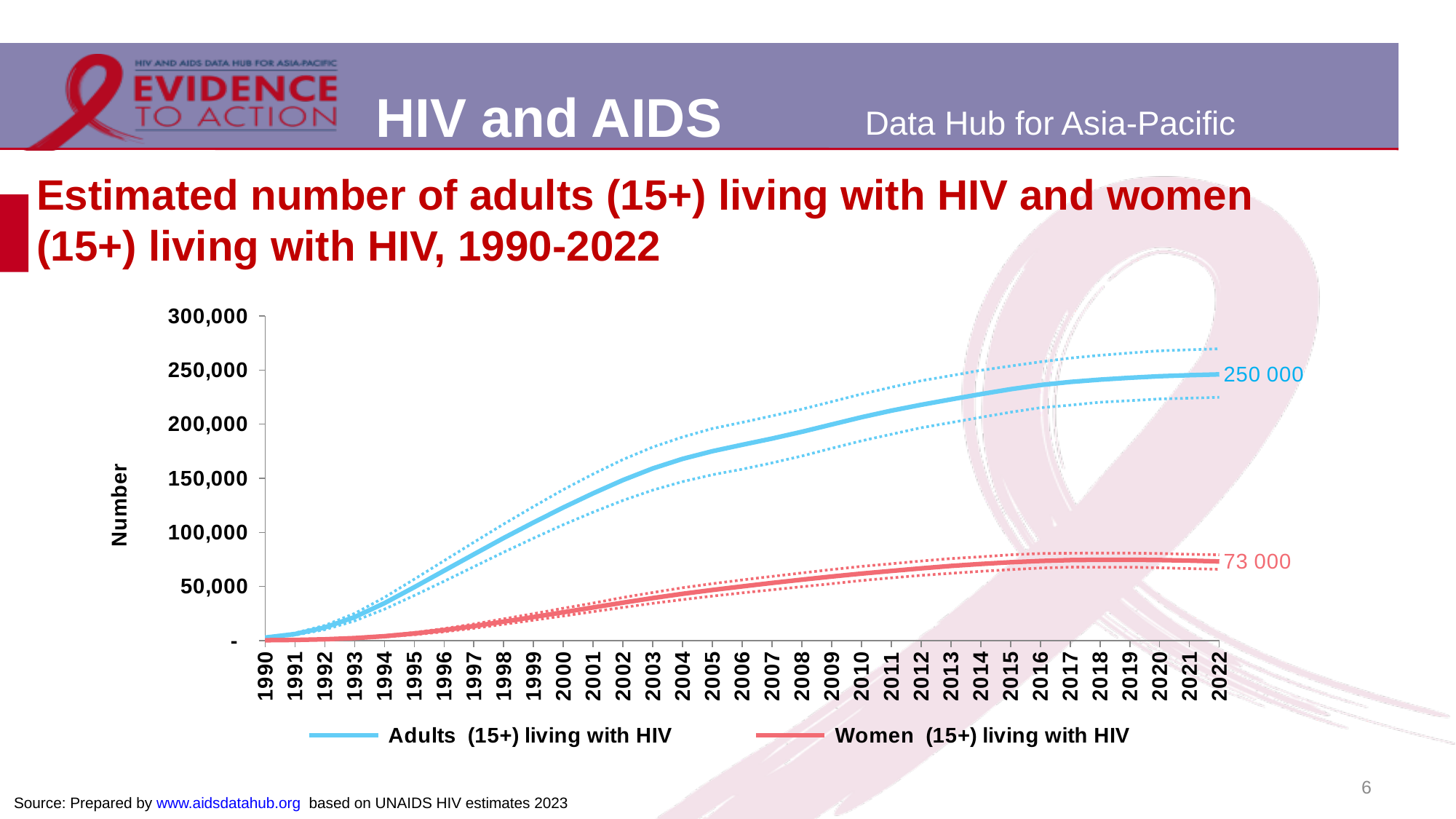
Do the values for adults (15+) living with HIV rise or fall from 1990 to 2022? Rise How many years are shown on the x axis of the chart? 33 How many series does the legend list? 2 What is the estimated number of women (15+) living with HIV in 2022? 73 000 Is the value for women (15+) living with HIV in 2000 greater or less than 50,000? less What is the estimated number of adults (15+) living with HIV in 2022? 250 000 What is the title of the y axis? Number Is the value for adults (15+) living with HIV in 2000 greater or less than 100,000? greater What is the difference between the number of adults (15+) living with HIV and the number of women (15+) living with HIV in 2022? 177 000 Is the value for adults (15+) living with HIV in 2010 greater or less than 150,000? greater What kind of chart is shown on the slide? Line chart In 2022, which is larger: the number of adults (15+) living with HIV or the number of women (15+) living with HIV? Adults (15+) living with HIV